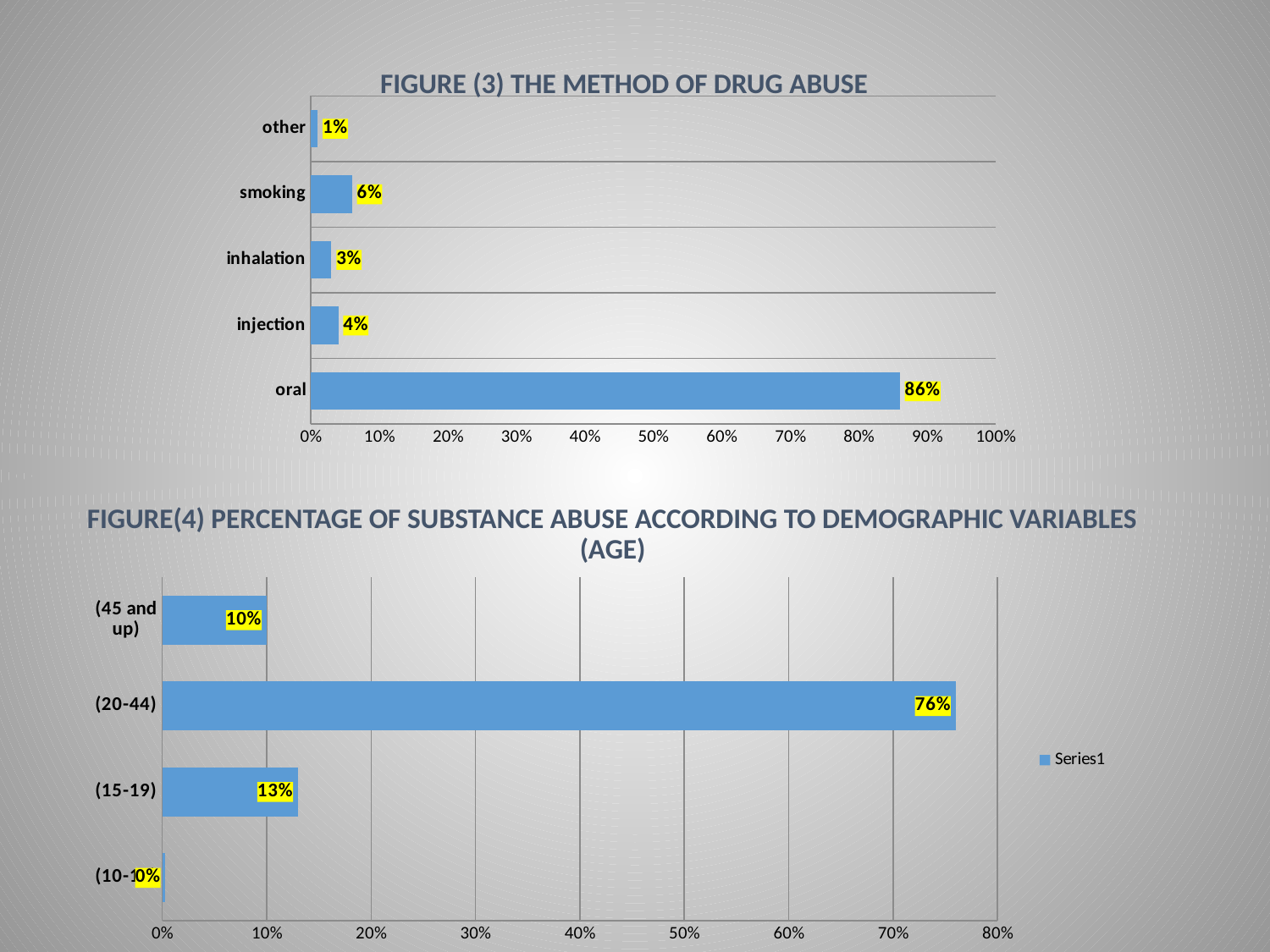
In the chart titled 'Figure (3) The Method of Drug Abuse', which method has the lowest value? other In the chart titled 'Figure(4) Percentage of Substance Abuse According to Demographic Variables (Age)', what is the value for the (20-44) age group? 76% In the chart titled 'Figure (3) The Method of Drug Abuse', what is the value for smoking? 6% In the chart titled 'Figure (3) The Method of Drug Abuse', how many methods are shown? 5 In the chart titled 'Figure (3) The Method of Drug Abuse', what is the difference between the values for injection and inhalation? 1% What kind of chart is the top chart, 'Figure (3) The Method of Drug Abuse'? bar chart In the chart titled 'Figure(4) Percentage of Substance Abuse According to Demographic Variables (Age)', what is the value for the (15-19) age group? 13% In the chart titled 'Figure(4) Percentage of Substance Abuse According to Demographic Variables (Age)', how many series does the legend list? 1 In the chart titled 'Figure(4) Percentage of Substance Abuse According to Demographic Variables (Age)', what is the difference between the values for (20-44) and (45 and up)? 66% In the chart titled 'Figure (3) The Method of Drug Abuse', which method has the highest value? oral In the chart titled 'Figure (3) The Method of Drug Abuse', what is the value for oral? 86% In the chart titled 'Figure(4) Percentage of Substance Abuse According to Demographic Variables (Age)', which is larger, the value for (45 and up) or the value for (15-19)? (15-19)